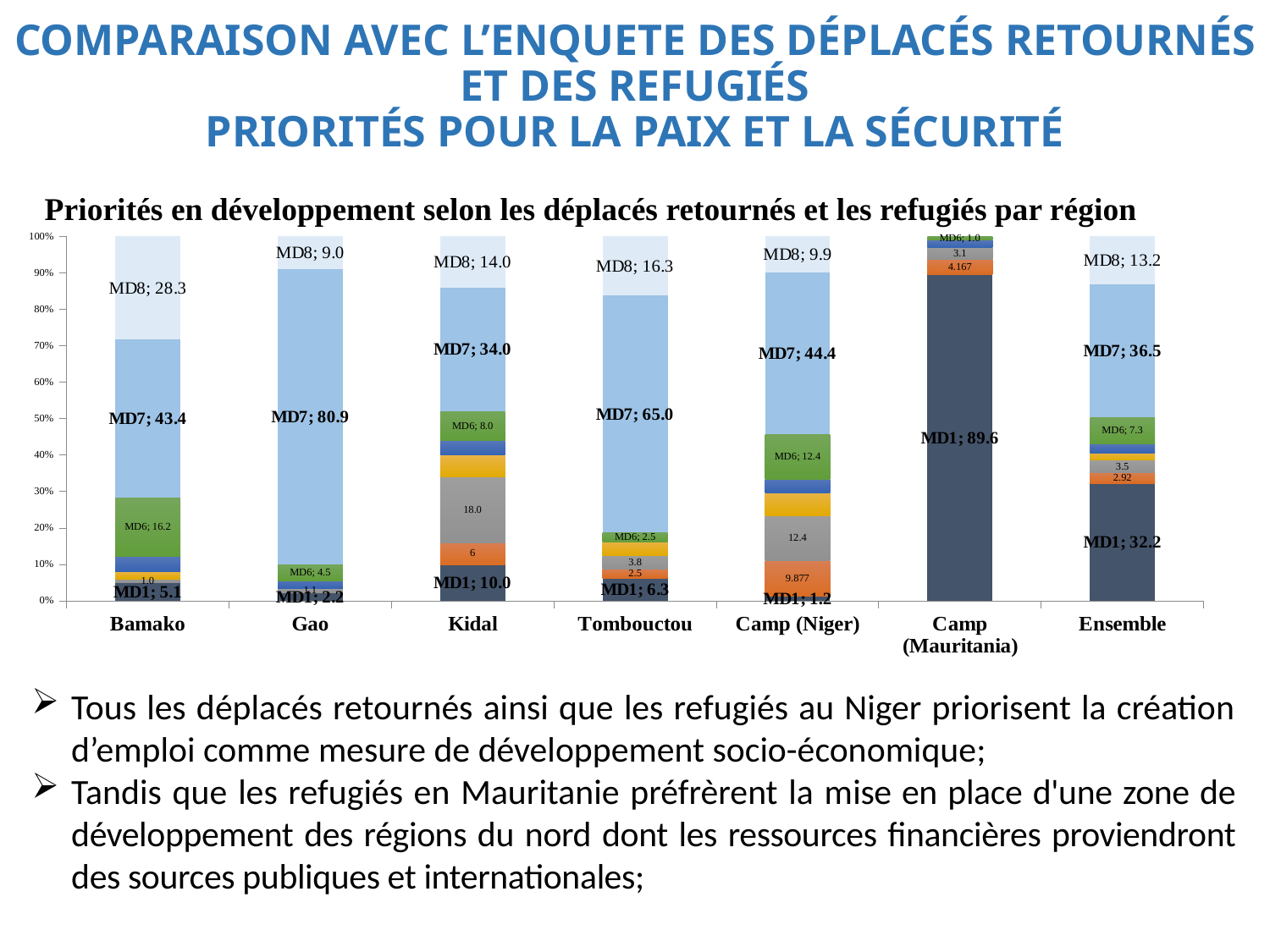
Which region has the lowest MD1 value? Camp (Niger) Which is larger: the MD8 value for Ensemble or the MD8 value for Kidal? Kidal What is the MD6 value for Camp (Niger)? 12.4 What kind of chart is shown on the slide? stacked bar chart How many regions (categories) are shown on the x axis of the chart? 7 What is the MD1 value for Ensemble? 32.2 Which region has the highest MD7 value? Gao What is the difference between the MD7 value for Tombouctou and the MD7 value for Kidal? 31.0 What is the title of the chart? Priorités en développement selon les déplacés retournés et les refugiés par région What is the MD1 value for Camp (Mauritania)? 89.6 What is the MD8 value for Bamako? 28.3 What is the MD7 value for Gao? 80.9